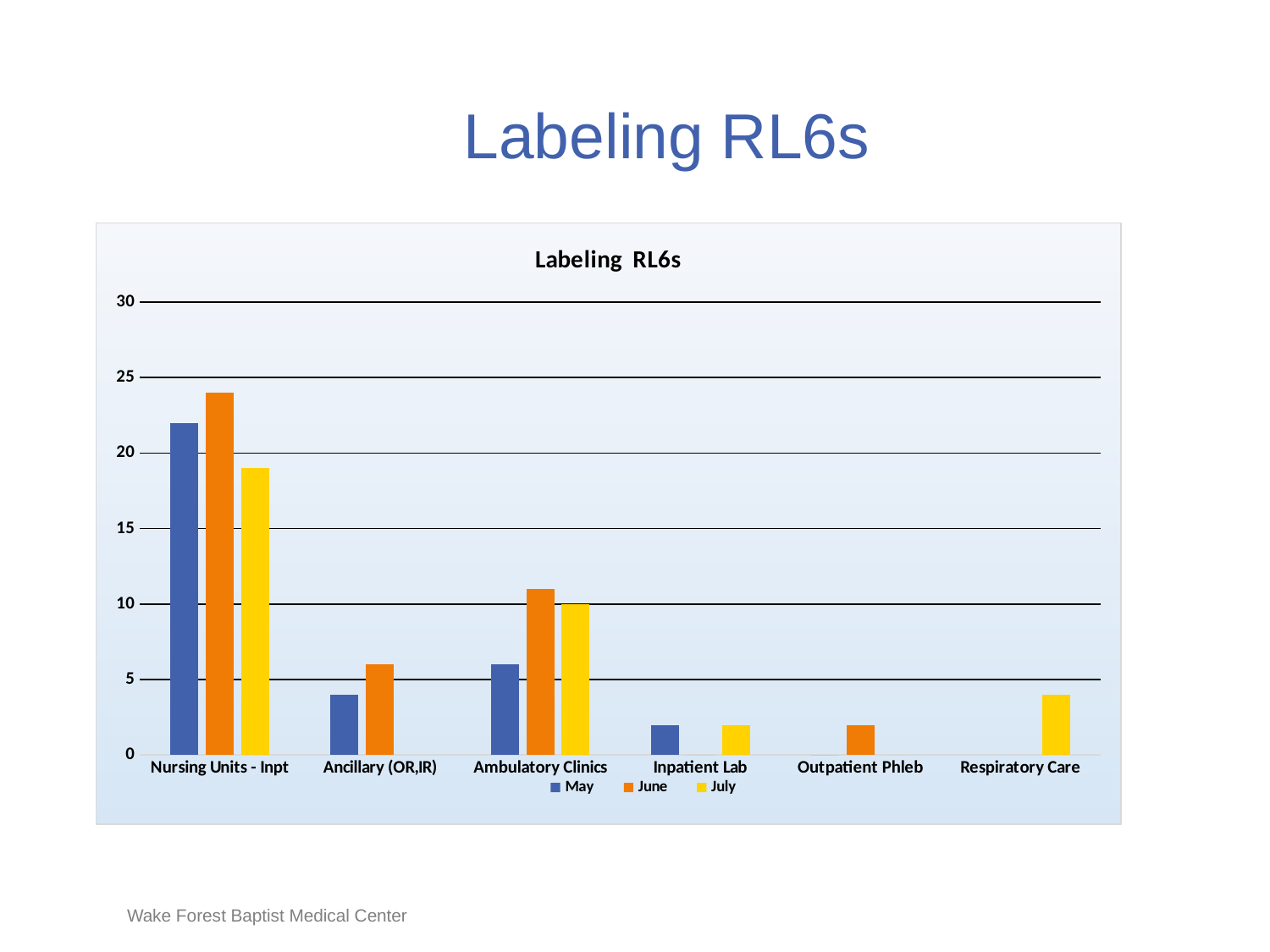
Is the June value for Ambulatory Clinics greater or less than 10? greater Which series is shown in orange in the chart's legend? June How many series does the chart's legend list? 3 How many categories are shown on the x axis of the chart? 6 For Nursing Units - Inpt, which month has the tallest bar? June Is the July value for Nursing Units - Inpt greater or less than 20? less What kind of chart is shown on the slide? bar chart Is the May value for Ancillary (OR,IR) greater or less than 5? less Which is larger for Nursing Units - Inpt, the May value or the July value? May Which category has the highest bars in the chart? Nursing Units - Inpt What is the title of the chart? Labeling RL6s